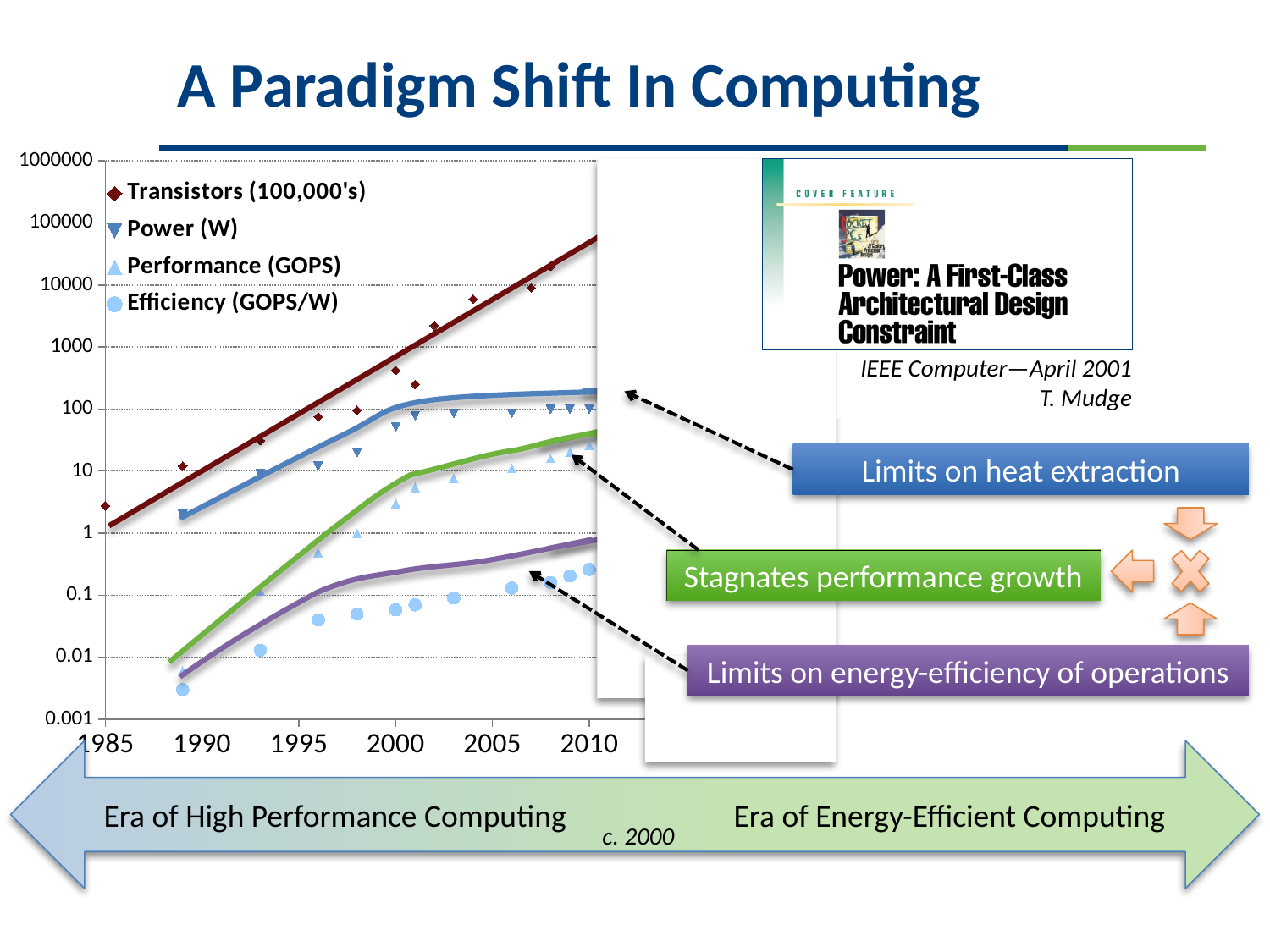
Is the Performance (GOPS) value for 2010 greater or less than 10? greater What is the unit given in the legend for the Efficiency series? GOPS/W Around 2010, which is larger: the Power (W) value or the Performance (GOPS) value? Power (W) Do the Transistors (100,000's) values rise or fall from 1985 to 2010? Rise Is the Efficiency (GOPS/W) value for 2010 greater or less than 0.1? greater Which series in the legend is plotted with diamond markers? Transistors (100,000's) Is the Performance (GOPS) value for 1989 greater or less than 0.01? less How many series does the chart legend list? 4 Which series has the highest values across the whole chart? Transistors (100,000's) What kind of chart is shown on the slide? Scatter chart